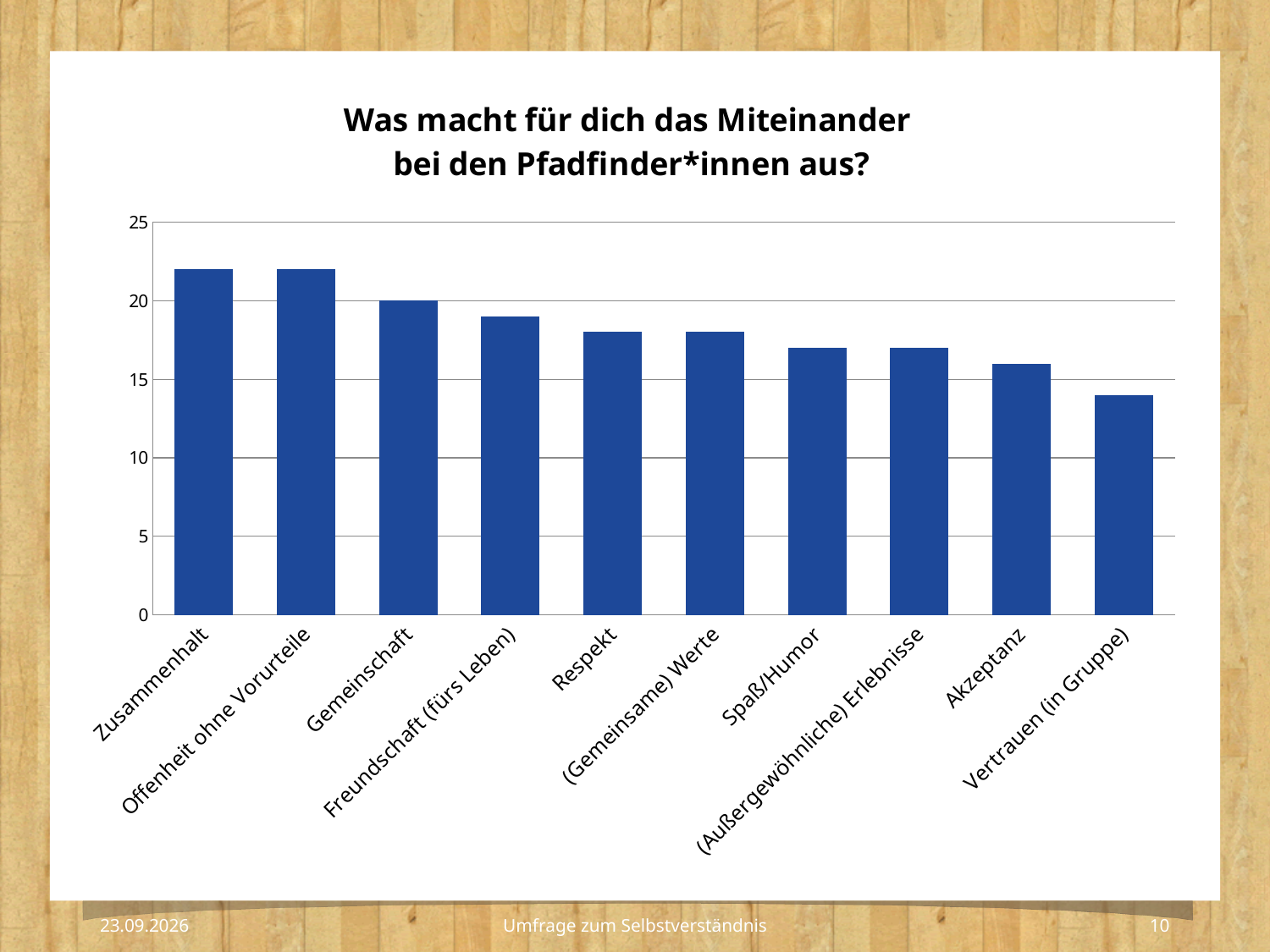
Is the value for Zusammenhalt greater or less than 20? greater Is the value for Vertrauen (in Gruppe) greater or less than 15? less Which is larger, the value for Gemeinschaft or the value for Akzeptanz? Gemeinschaft Which is larger, the value for Zusammenhalt or the value for Vertrauen (in Gruppe)? Zusammenhalt Is the value for Akzeptanz greater or less than 15? greater What is the title of the chart? Was macht für dich das Miteinander bei den Pfadfinder*innen aus? How many categories are shown on the x axis of the chart? 10 Which category has the lowest value in the chart? Vertrauen (in Gruppe) What is the value for Gemeinschaft? 20 What kind of chart is shown on the slide? bar chart Do the values rise or fall from left to right along the x axis? fall